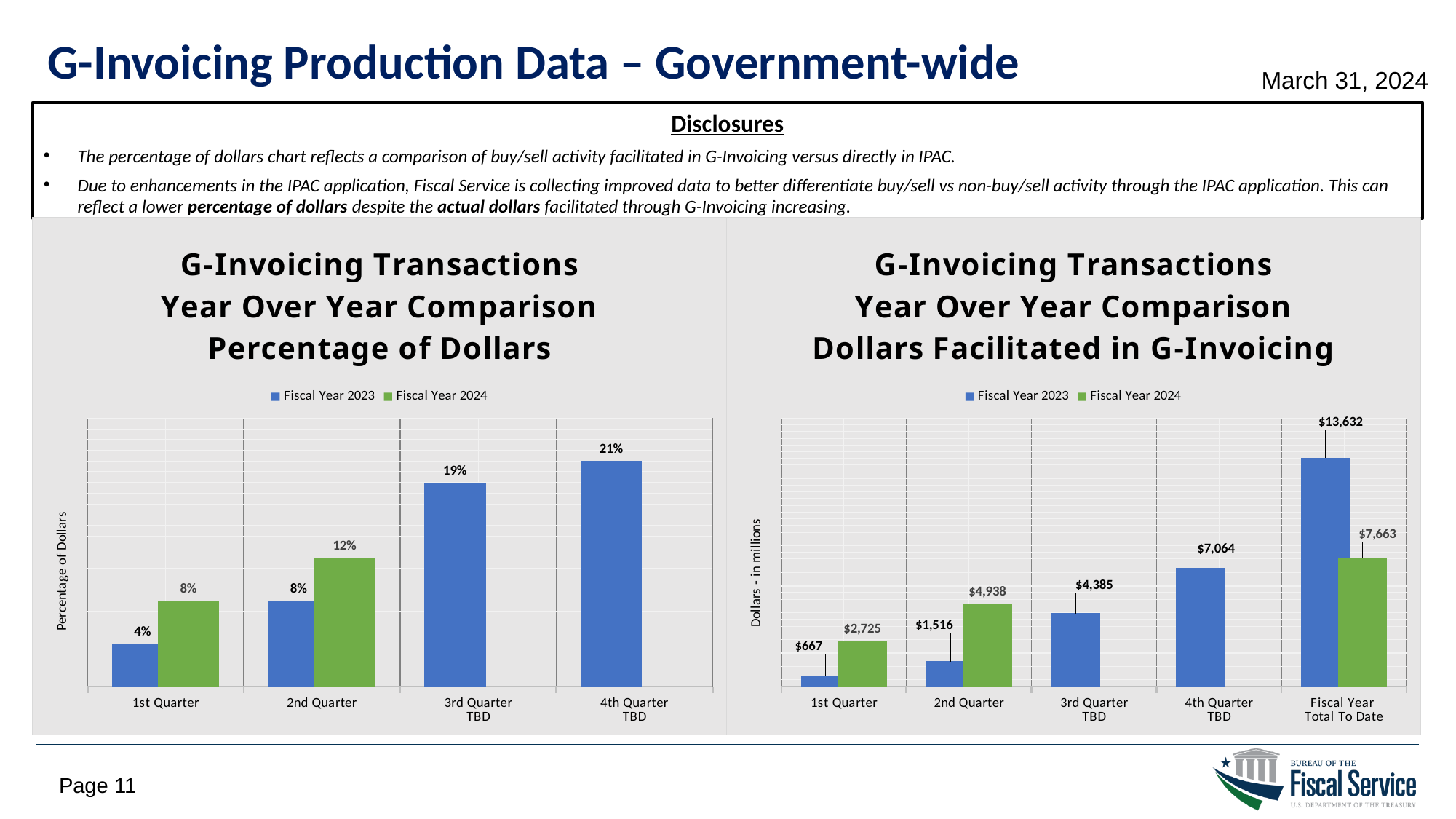
In the Percentage of Dollars chart, which quarter has the highest Fiscal Year 2023 value? 4th Quarter How many series does the legend of the Dollars Facilitated in G-Invoicing chart list? 2 What kind of chart is the Percentage of Dollars chart? bar chart In the Percentage of Dollars chart, what is the Fiscal Year 2023 value for the 3rd Quarter? 19% In the Dollars Facilitated in G-Invoicing chart, which quarter has the lowest Fiscal Year 2023 value? 1st Quarter In the Dollars Facilitated in G-Invoicing chart, what is the Fiscal Year 2023 value for the 2nd Quarter? $1,516 In the Dollars Facilitated in G-Invoicing chart, what is the difference between the Fiscal Year 2024 and Fiscal Year 2023 values for the 1st Quarter? $2,058 In the Dollars Facilitated in G-Invoicing chart, which is larger for the 2nd Quarter: Fiscal Year 2023 or Fiscal Year 2024? Fiscal Year 2024 In the Dollars Facilitated in G-Invoicing chart, what is the Fiscal Year 2024 value for the Fiscal Year Total To Date? $7,663 In the Percentage of Dollars chart, what is the difference between the Fiscal Year 2024 and Fiscal Year 2023 values for the 1st Quarter? 4% In the Percentage of Dollars chart, do the Fiscal Year 2023 values rise or fall from the 1st Quarter to the 4th Quarter? rise In the Percentage of Dollars chart, what is the Fiscal Year 2024 value for the 2nd Quarter? 12%